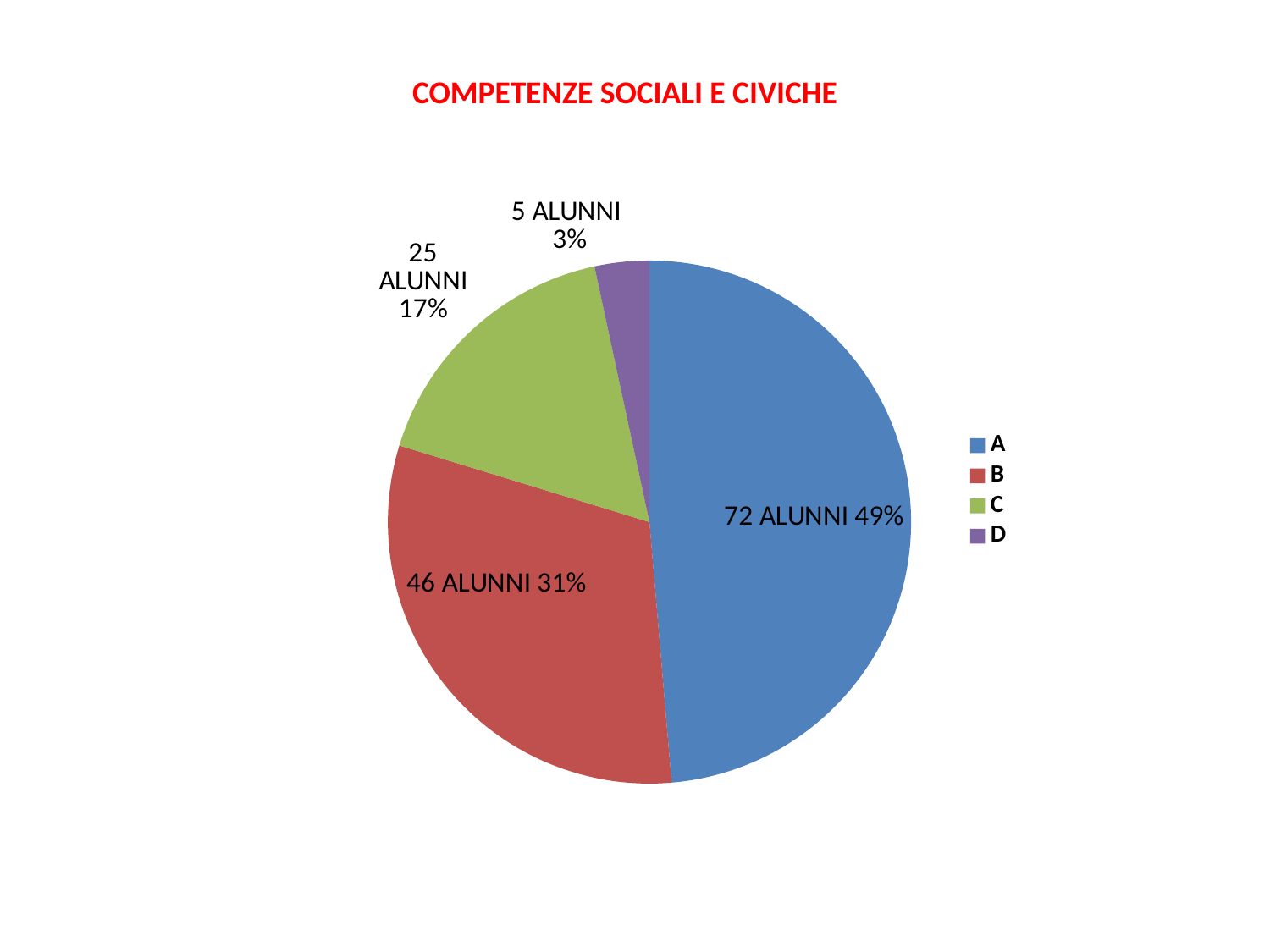
Which category has the smallest slice? D What is the title of the chart? COMPETENZE SOCIALI E CIVICHE Which category has more students, C or D? C What kind of chart is shown on the slide? pie chart How many more students are in category A than in category B? 26 What percentage share does category D have? 3% What percentage share does category B have? 31% Which category has the largest slice? A How many students (alunni) are in category A? 72 ALUNNI What colour is the slice for category C? green How many students (alunni) are in category C? 25 ALUNNI How many categories does the legend list? 4